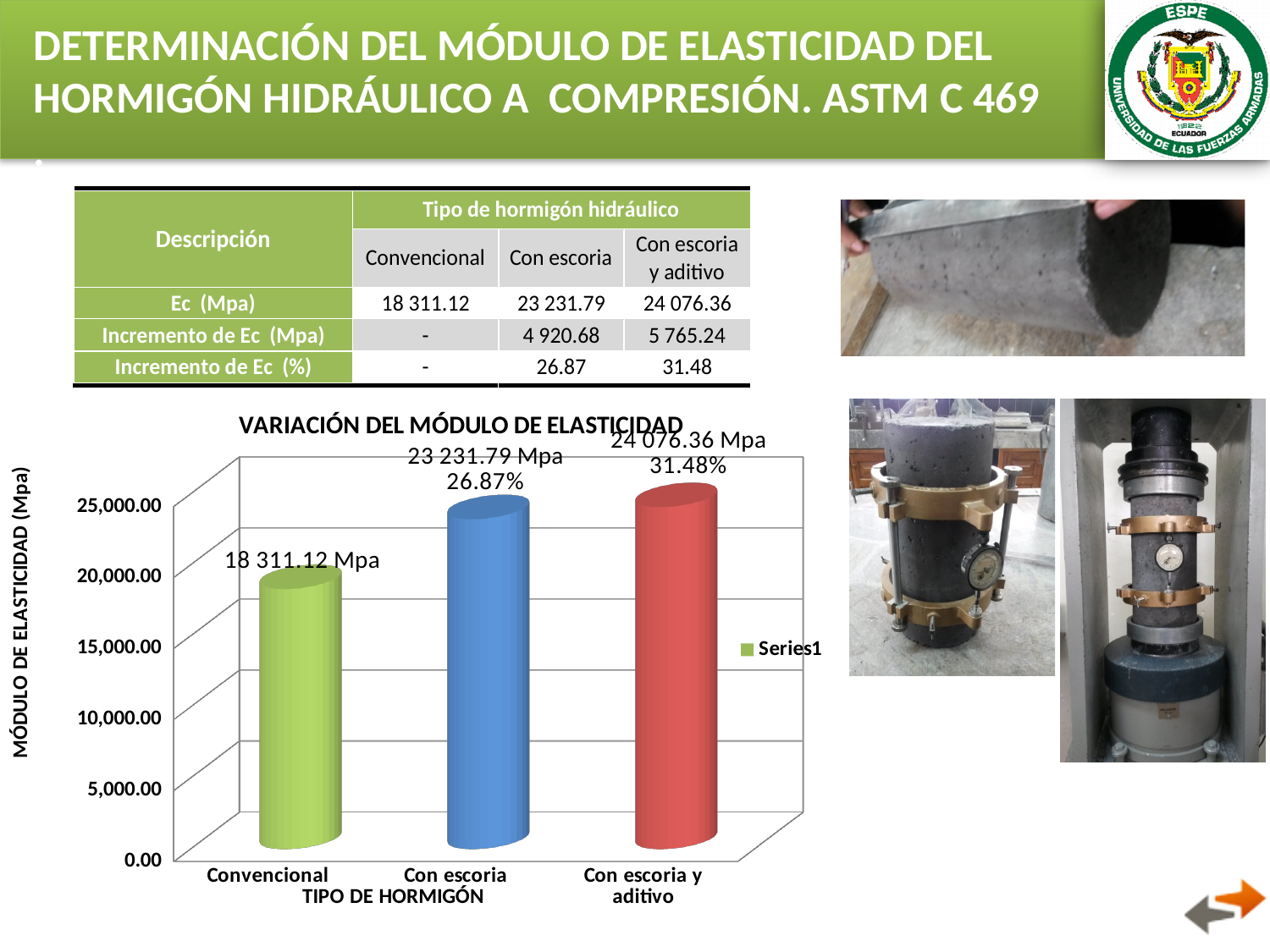
What is the value shown for Con escoria y aditivo in the chart? 24 076.36 Mpa What is the difference between the values for Con escoria y aditivo and Convencional? 5 765.24 Mpa How many types of hormigón are plotted in the chart? 3 What is the value shown for Con escoria in the chart? 23 231.79 Mpa What percentage is printed above the Con escoria bar? 26.87% Which type of hormigón has the lowest módulo de elasticidad in the chart? Convencional What kind of chart is shown on the slide? Bar chart Is the value for Convencional greater or less than 20,000.00? less Which is larger, the value for Con escoria or the value for Con escoria y aditivo? Con escoria y aditivo What percentage is printed above the Con escoria y aditivo bar? 31.48% What is the value shown for Convencional in the chart? 18 311.12 Mpa Which type of hormigón has the highest módulo de elasticidad in the chart? Con escoria y aditivo